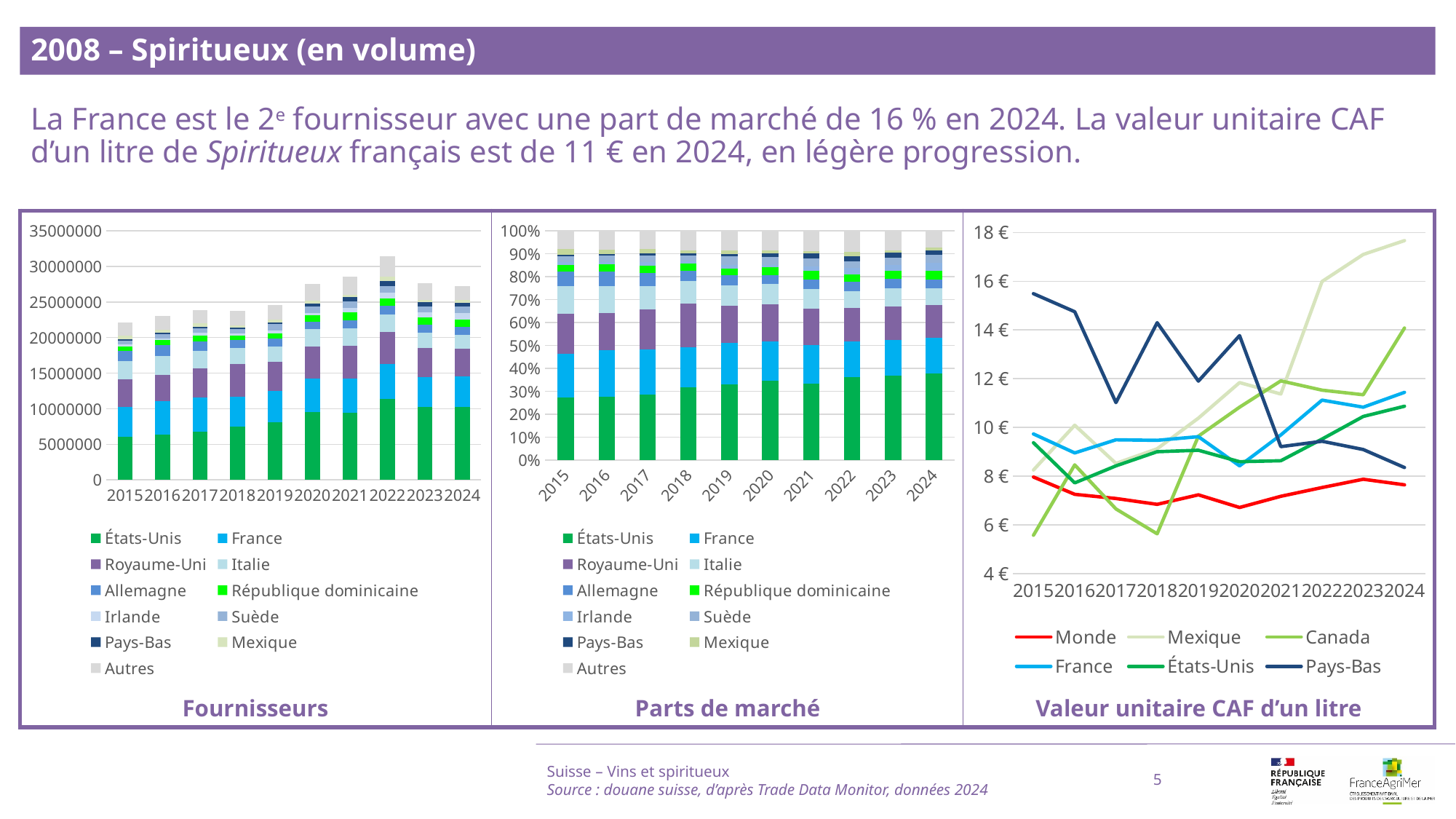
In the 'Fournisseurs' chart, which year has the tallest stacked bar? 2022 How many years are shown on the x axis of the 'Fournisseurs' chart? 10 In the 'Parts de marché' chart, does the share of États-Unis rise or fall from 2015 to 2024? rise What kind of chart is the 'Valeur unitaire CAF d'un litre' chart? line chart How many series does the legend of the 'Valeur unitaire CAF d'un litre' chart list? 6 What kind of chart is the 'Fournisseurs' chart? bar chart In the 'Valeur unitaire CAF d'un litre' chart, is the value for Pays-Bas in 2015 greater or less than 14 €? greater How many series does the legend of the 'Fournisseurs' chart list? 11 In the 'Fournisseurs' chart, is the total bar for 2015 greater or less than 25000000? less In the 'Parts de marché' chart, is the share of États-Unis in 2024 greater or less than 30%? greater In the 'Valeur unitaire CAF d'un litre' chart, which series has the highest value in 2024? Mexique